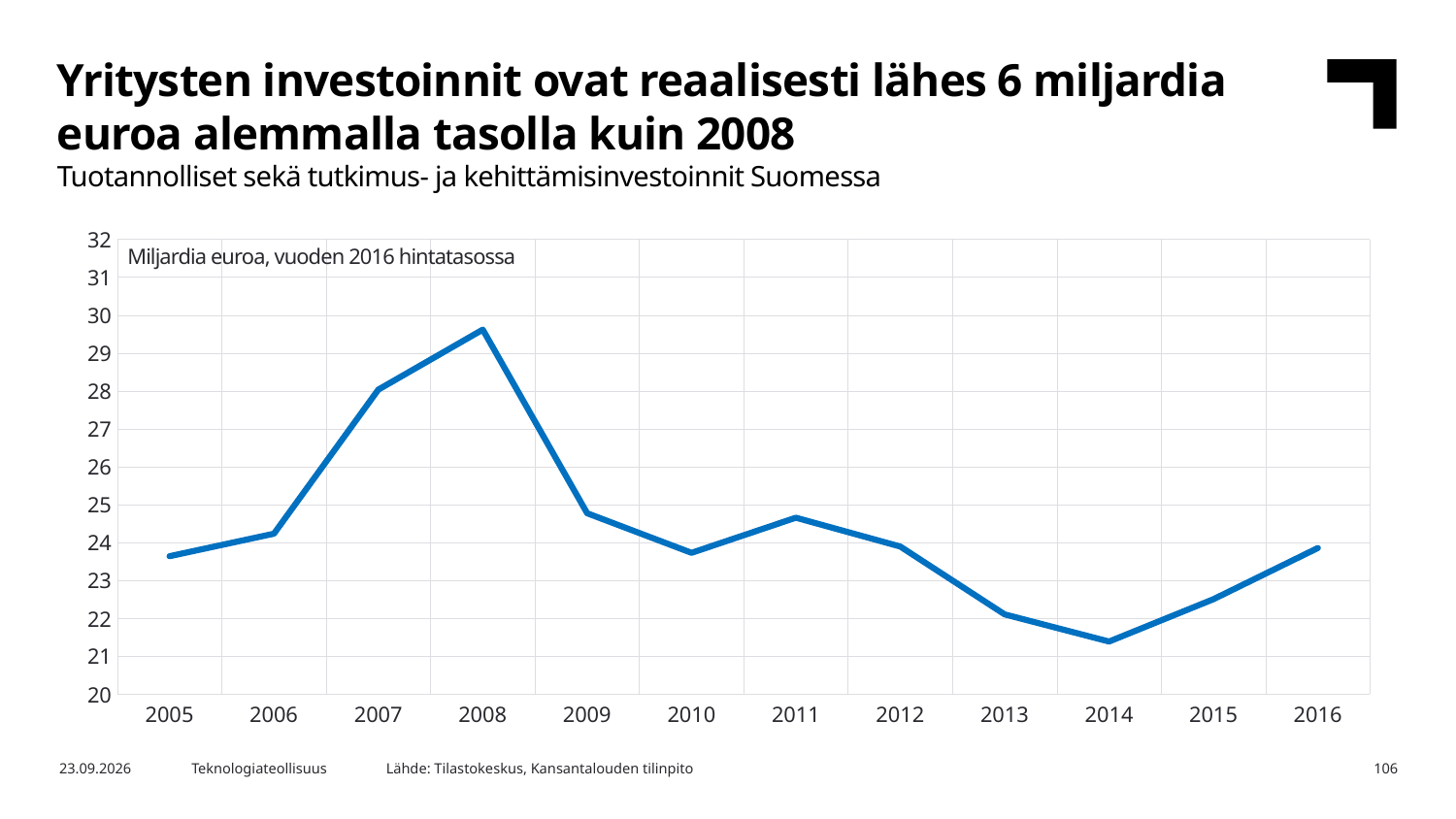
What kind of chart is shown on the slide? line chart How many years are plotted on the x axis of the chart? 12 Is the value for 2008 greater or less than 29? greater Is the value for 2007 greater or less than 27? greater Which year has the larger value, 2009 or 2013? 2009 In which year does the line reach its lowest value? 2014 In which year does the line reach its highest value? 2008 Do the values rise or fall between 2008 and 2010? fall Is the value for 2014 greater or less than 22? less Which year has the larger value, 2007 or 2011? 2007 What unit is stated in the label inside the chart area? Miljardia euroa, vuoden 2016 hintatasossa